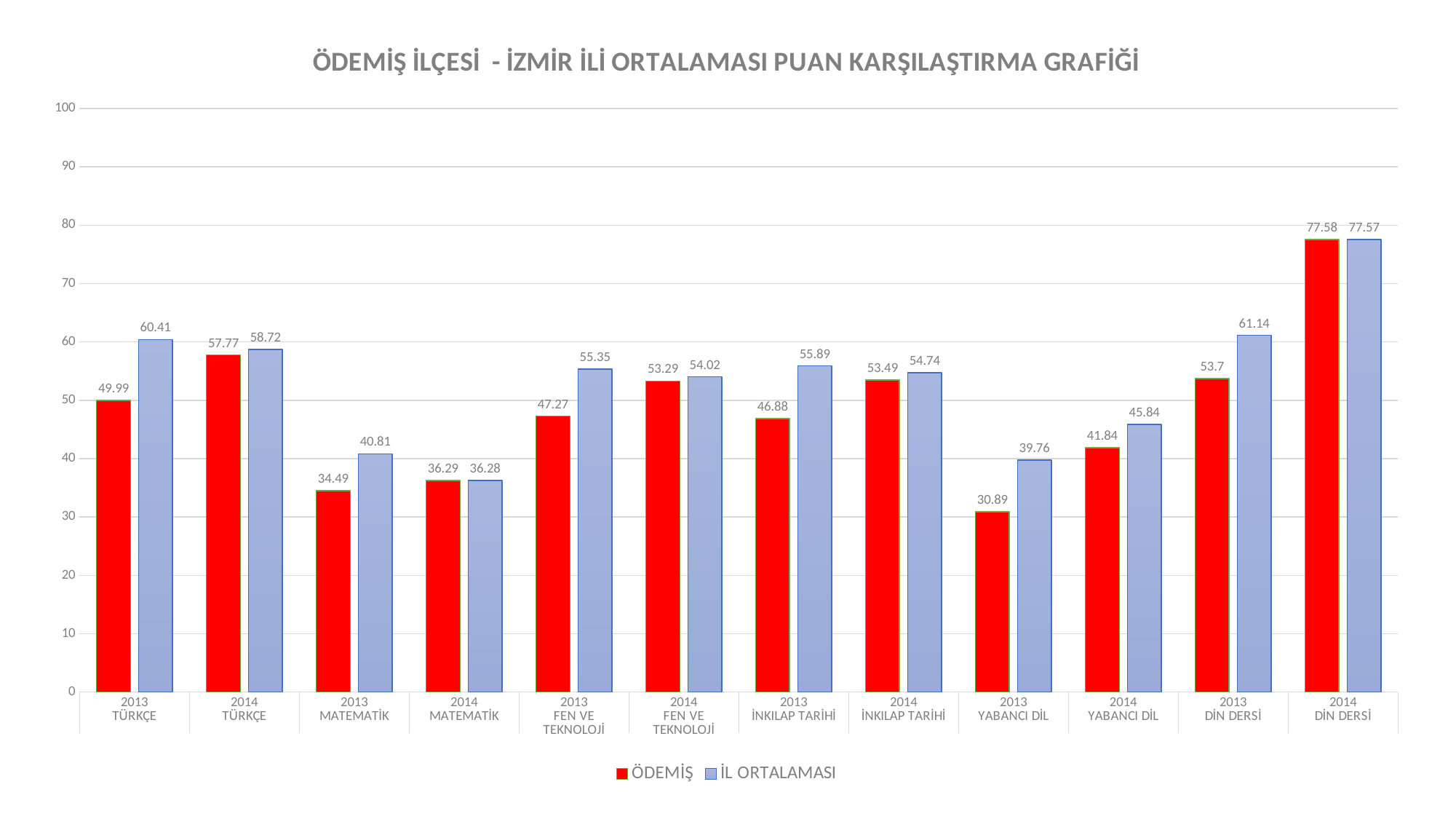
How many categories are shown on the x axis? 12 What is the İL ORTALAMASI value for 2014 DİN DERSİ? 77.57 Which is larger for 2013 FEN VE TEKNOLOJİ, the ÖDEMİŞ value or the İL ORTALAMASI value? İL ORTALAMASI What is the ÖDEMİŞ value for 2013 TÜRKÇE? 49.99 What is the ÖDEMİŞ value for 2013 YABANCI DİL? 30.89 What is the difference between the İL ORTALAMASI and ÖDEMİŞ values for 2013 TÜRKÇE? 10.42 What colour are the ÖDEMİŞ bars? red Is the ÖDEMİŞ value for 2014 YABANCI DİL greater or less than 40? greater Which category has the highest ÖDEMİŞ value? 2014 DİN DERSİ How many series does the legend list? 2 Which category has the lowest İL ORTALAMASI value? 2014 MATEMATİK What kind of chart is shown on the slide? bar chart